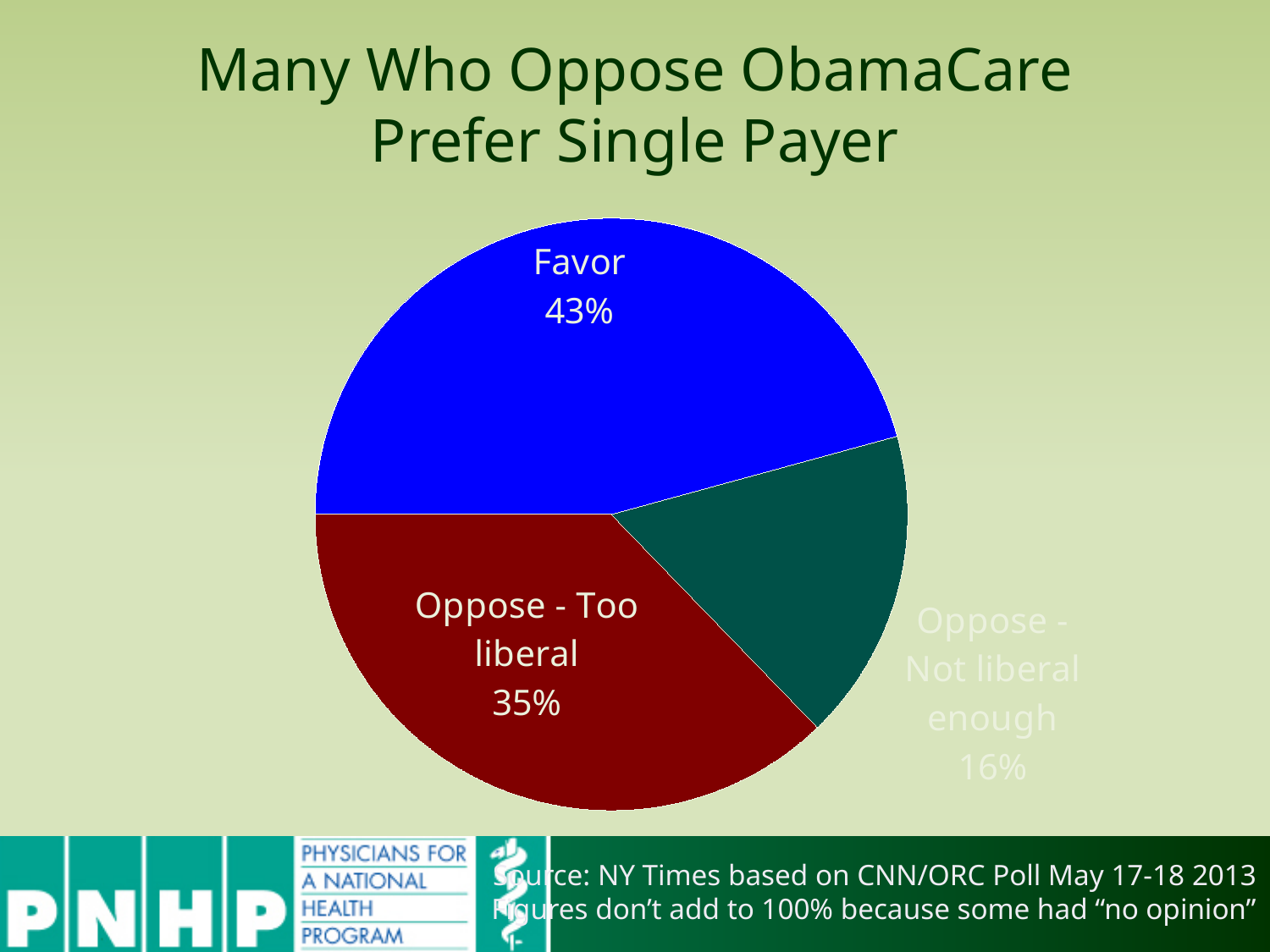
What kind of chart is shown on the slide? Pie chart Which is larger, the Favor slice or the Oppose - Too liberal slice? Favor What colour is the Favor slice of the pie chart? Blue Which slice of the pie chart is the largest? Favor What percentage of respondents favor ObamaCare according to the pie chart? 43% What is the difference in percentage points between the Favor slice and the Oppose - Too liberal slice? 8 What percentage of respondents oppose ObamaCare because it is too liberal? 35% What is the difference in percentage points between the Oppose - Too liberal slice and the Oppose - Not liberal enough slice? 19 How many slices does the pie chart have? 3 Which slice of the pie chart is the smallest? Oppose - Not liberal enough What is the title of the slide containing the pie chart? Many Who Oppose ObamaCare Prefer Single Payer What percentage of respondents oppose ObamaCare because it is not liberal enough? 16%